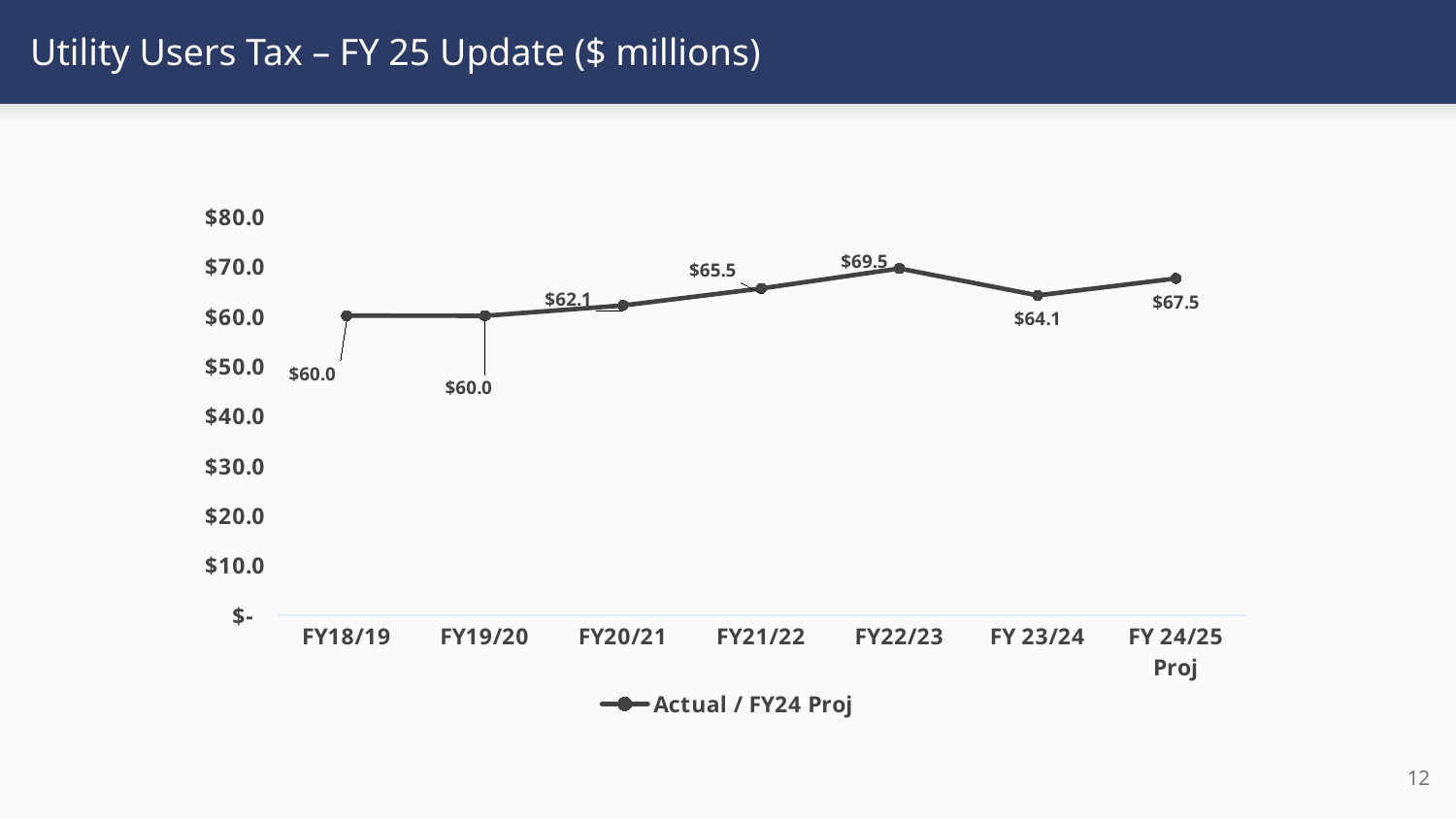
Which fiscal year has the highest value? FY22/23 How many fiscal years are plotted on the chart? 7 What kind of chart is shown on the slide? Line chart What is the legend entry for the plotted series? Actual / FY24 Proj What is the value for FY20/21? $62.1 Is the value for FY22/23 greater or less than $60.0? greater How many series does the legend list? 1 Which is larger, the value for FY21/22 or the value for FY 24/25 Proj? FY 24/25 Proj What is the projected value for FY 24/25 Proj? $67.5 What is the difference between the FY21/22 value and the FY20/21 value? $3.4 What is the value for FY 23/24? $64.1 What is the difference between the FY22/23 value and the FY 23/24 value? $5.4